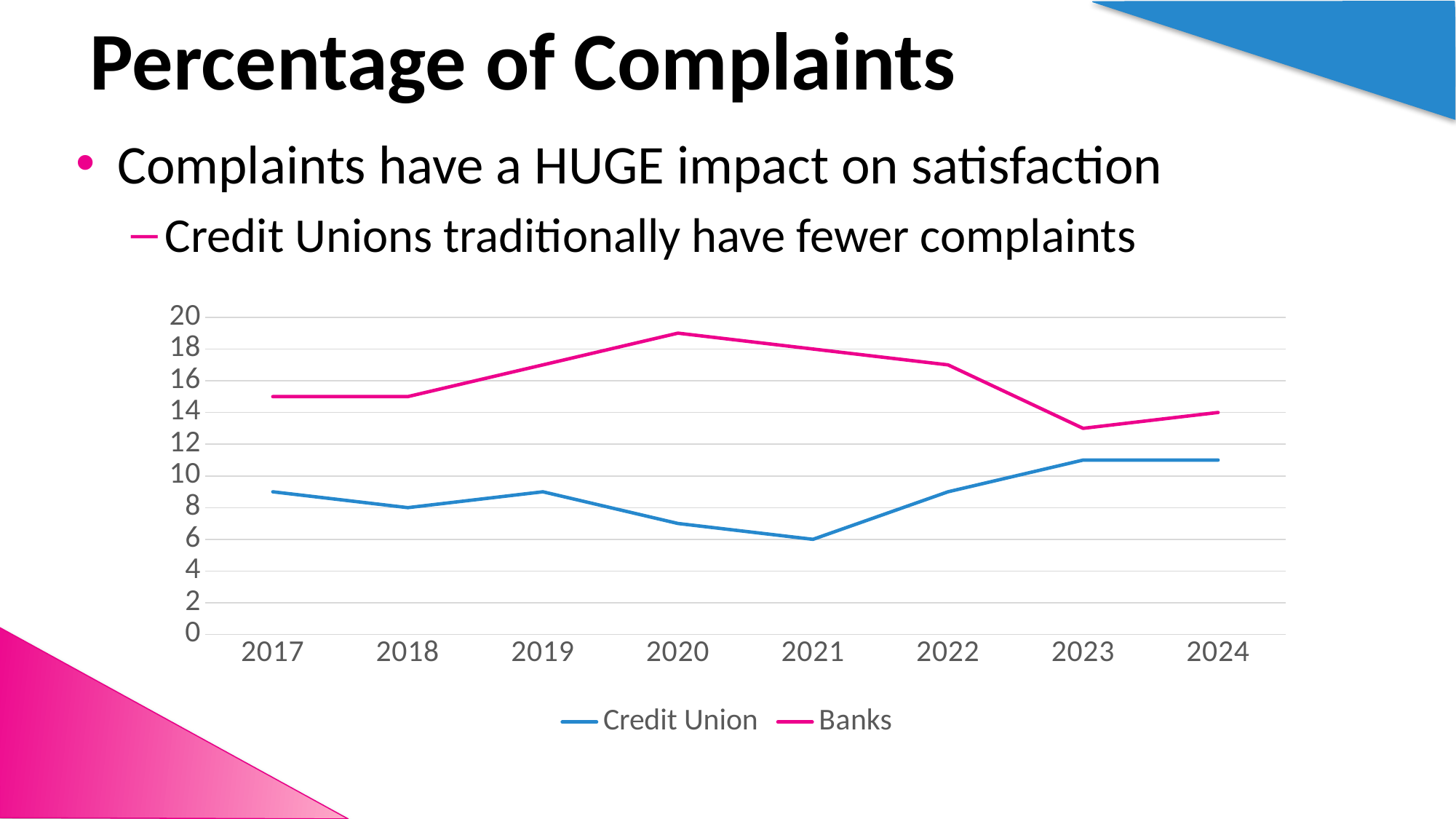
What kind of chart is shown on the slide? line chart How many series does the chart legend list? 2 Does the Credit Union line rise or fall from 2021 to 2023? rise Is the value for Banks in 2020 greater or less than 18? greater In 2020, which series has the higher value, Credit Union or Banks? Banks What are the two entries in the chart legend? Credit Union and Banks Is the value for Credit Union in 2017 greater or less than 10? less How many years are plotted along the x axis of the chart? 8 What is the value for Credit Union in 2021? 6 Does the Banks line rise or fall from 2020 to 2023? fall In which year does the Banks line reach its highest value? 2020 In which year does the Credit Union line reach its lowest value? 2021